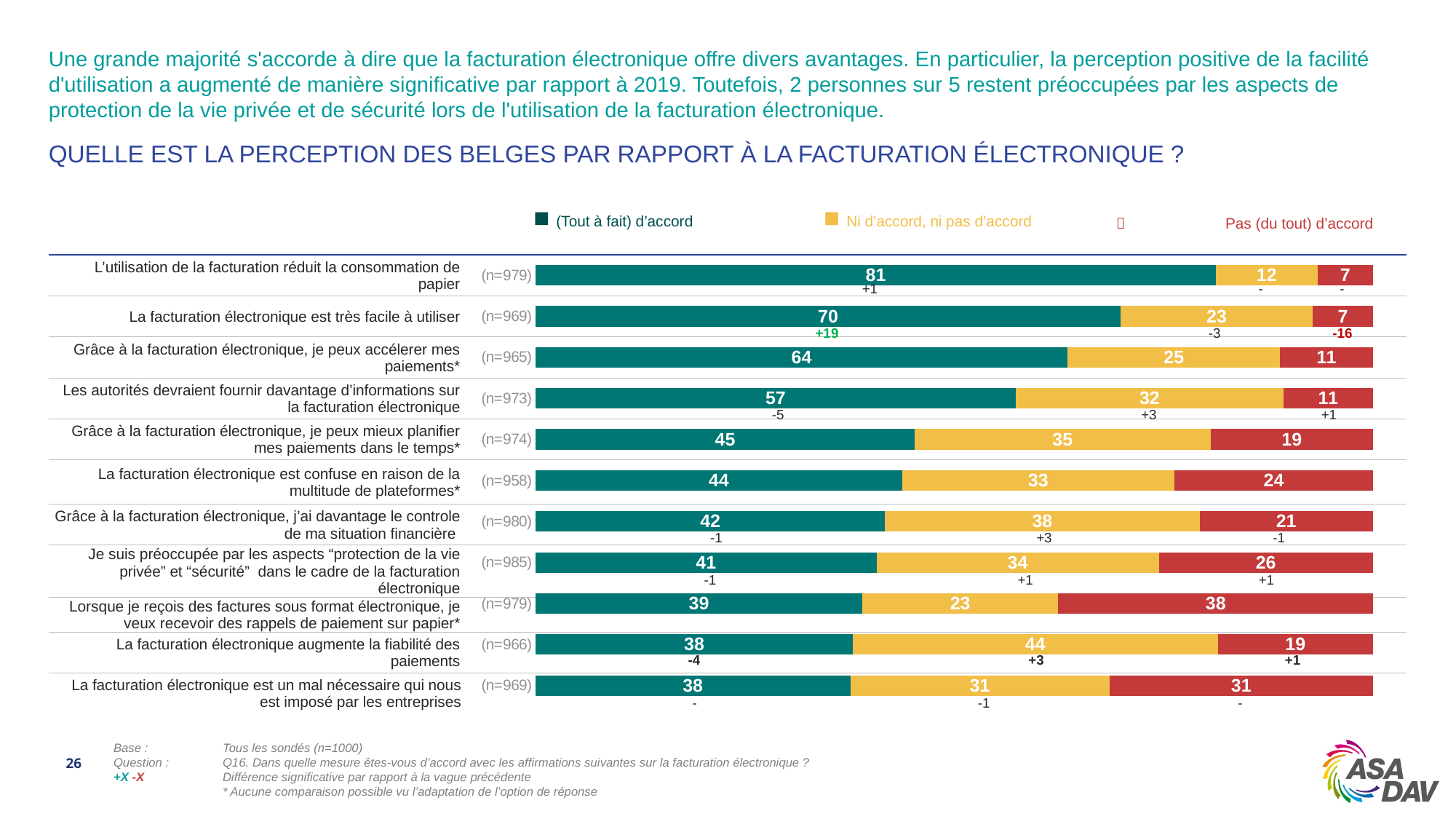
How many statements are shown in the chart? 11 What is the '(Tout à fait) d'accord' value for 'L'utilisation de la facturation réduit la consommation de papier'? 81 What colour represents the 'Pas (du tout) d'accord' series? Red Which statement has the highest 'Pas (du tout) d'accord' value? Lorsque je reçois des factures sous format électronique, je veux recevoir des rappels de paiement sur papier* What is the difference between the '(Tout à fait) d'accord' values for 'La facturation électronique est très facile à utiliser' and 'Grâce à la facturation électronique, je peux accélérer mes paiements*'? 6 What is the sample size (n) shown for 'Je suis préoccupée par les aspects "protection de la vie privée" et "sécurité" dans le cadre de la facturation électronique'? n=985 How many series does the legend list? 3 What is the 'Ni d'accord, ni pas d'accord' value for 'La facturation électronique augmente la fiabilité des paiements'? 44 What is the 'Pas (du tout) d'accord' value for 'Lorsque je reçois des factures sous format électronique, je veux recevoir des rappels de paiement sur papier*'? 38 Which is larger: the 'Ni d'accord, ni pas d'accord' value for 'Les autorités devraient fournir davantage d'informations sur la facturation électronique' or for 'Grâce à la facturation électronique, je peux mieux planifier mes paiements dans le temps*'? Grâce à la facturation électronique, je peux mieux planifier mes paiements dans le temps* Which statement has the highest '(Tout à fait) d'accord' value? L'utilisation de la facturation réduit la consommation de papier What kind of chart is shown on the slide? Stacked bar chart